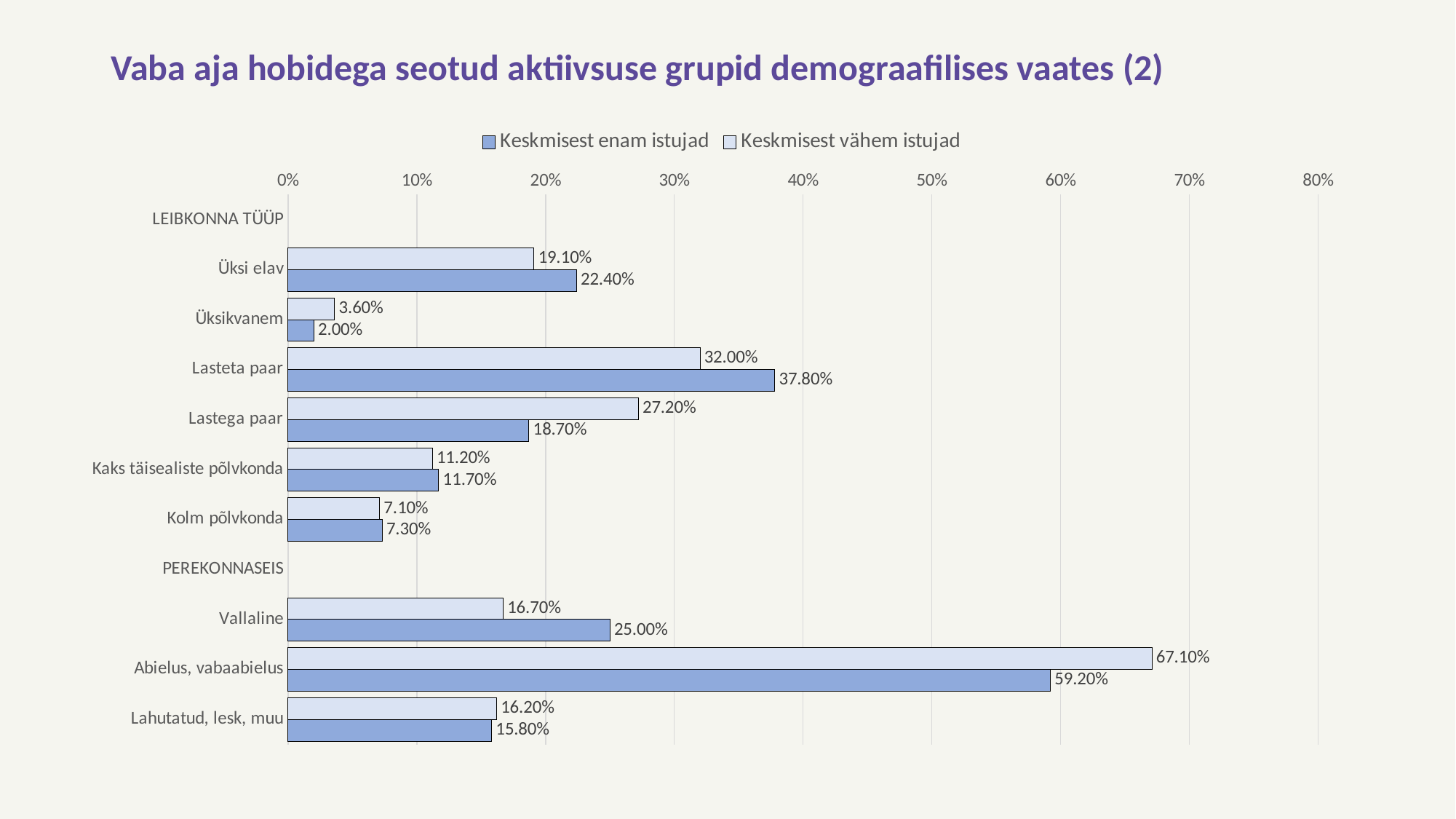
Which category has the highest value in the Keskmisest vähem istujad series? Abielus, vabaabielus What is the value for Lasteta paar in the Keskmisest enam istujad series? 37.80% For Vallaline, which series has the larger value: Keskmisest enam istujad or Keskmisest vähem istujad? Keskmisest enam istujad What type of chart is shown on the slide? bar chart What is the title of the chart? Vaba aja hobidega seotud aktiivsuse grupid demograafilises vaates (2) What is the value for Üksikvanem in the Keskmisest enam istujad series? 2.00% How many categories are listed under the PEREKONNASEIS group? 3 What is the value for Abielus, vabaabielus in the Keskmisest vähem istujad series? 67.10% How many series does the legend list? 2 What is the difference between the Keskmisest vähem istujad and Keskmisest enam istujad values for Lastega paar? 8.50% Which category has the lowest value in the Keskmisest enam istujad series? Üksikvanem Is the Keskmisest enam istujad value for Abielus, vabaabielus greater or less than 50%? greater